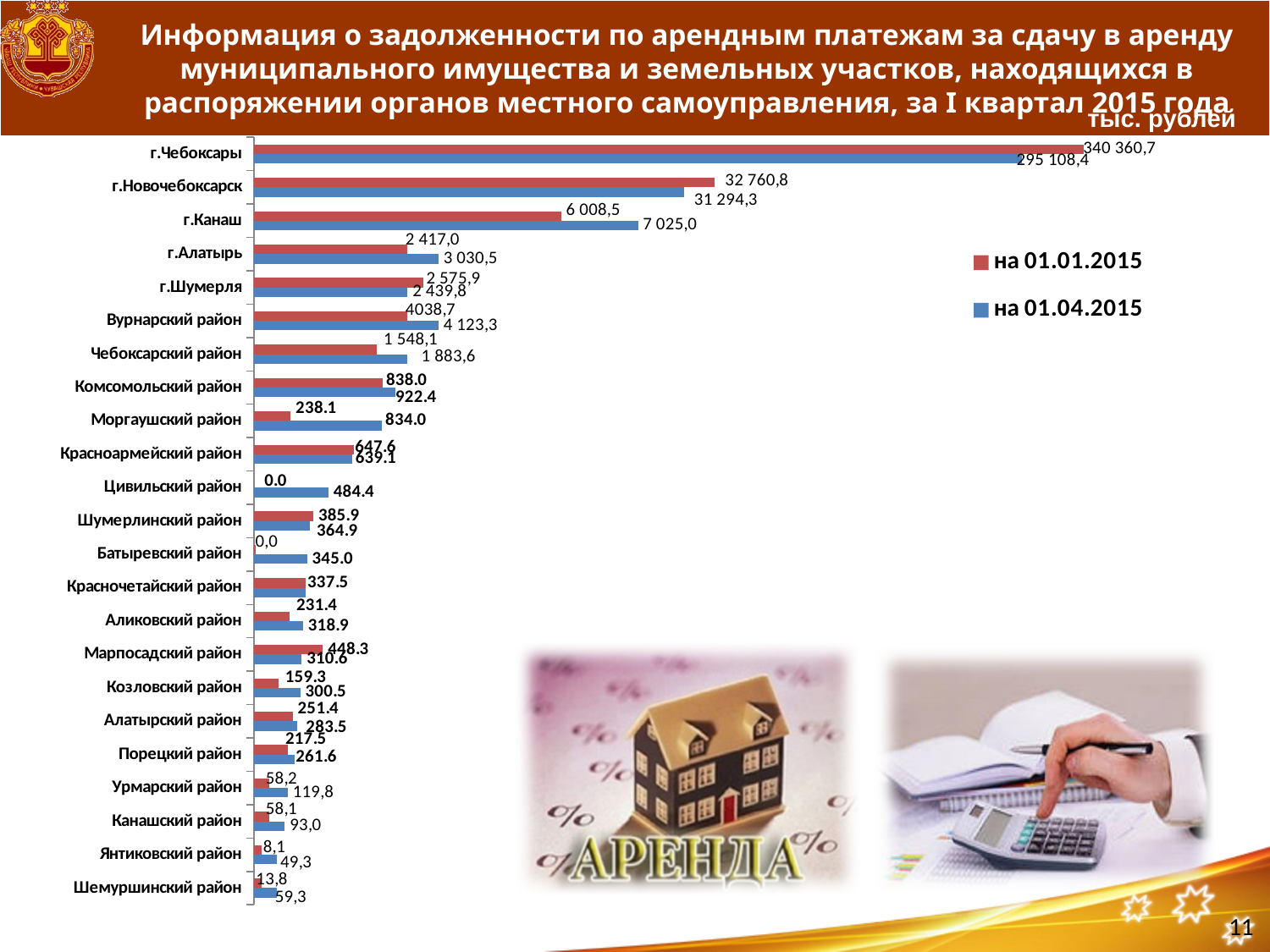
What is the value for г.Чебоксары in the series 'на 01.04.2015'? 295 108,4 For Марпосадский район, which is larger: the value 'на 01.01.2015' or 'на 01.04.2015'? на 01.01.2015 Which category has the highest value in the series 'на 01.01.2015'? г.Чебоксары How many categories (municipalities) are shown on the chart? 23 What is the value for Моргаушский район in the series 'на 01.04.2015'? 834.0 Which category has the lowest value in the series 'на 01.04.2015'? Янтиковский район What is the value for г.Новочебоксарск in the series 'на 01.01.2015'? 32 760,8 What is the value for Цивильский район in the series 'на 01.01.2015'? 0.0 How many series does the legend list? 2 What kind of chart is shown on the slide? bar chart What is the difference between the 'на 01.04.2015' and 'на 01.01.2015' values for г.Канаш? 1 016,5 Which colour represents the series 'на 01.04.2015' in the legend? blue